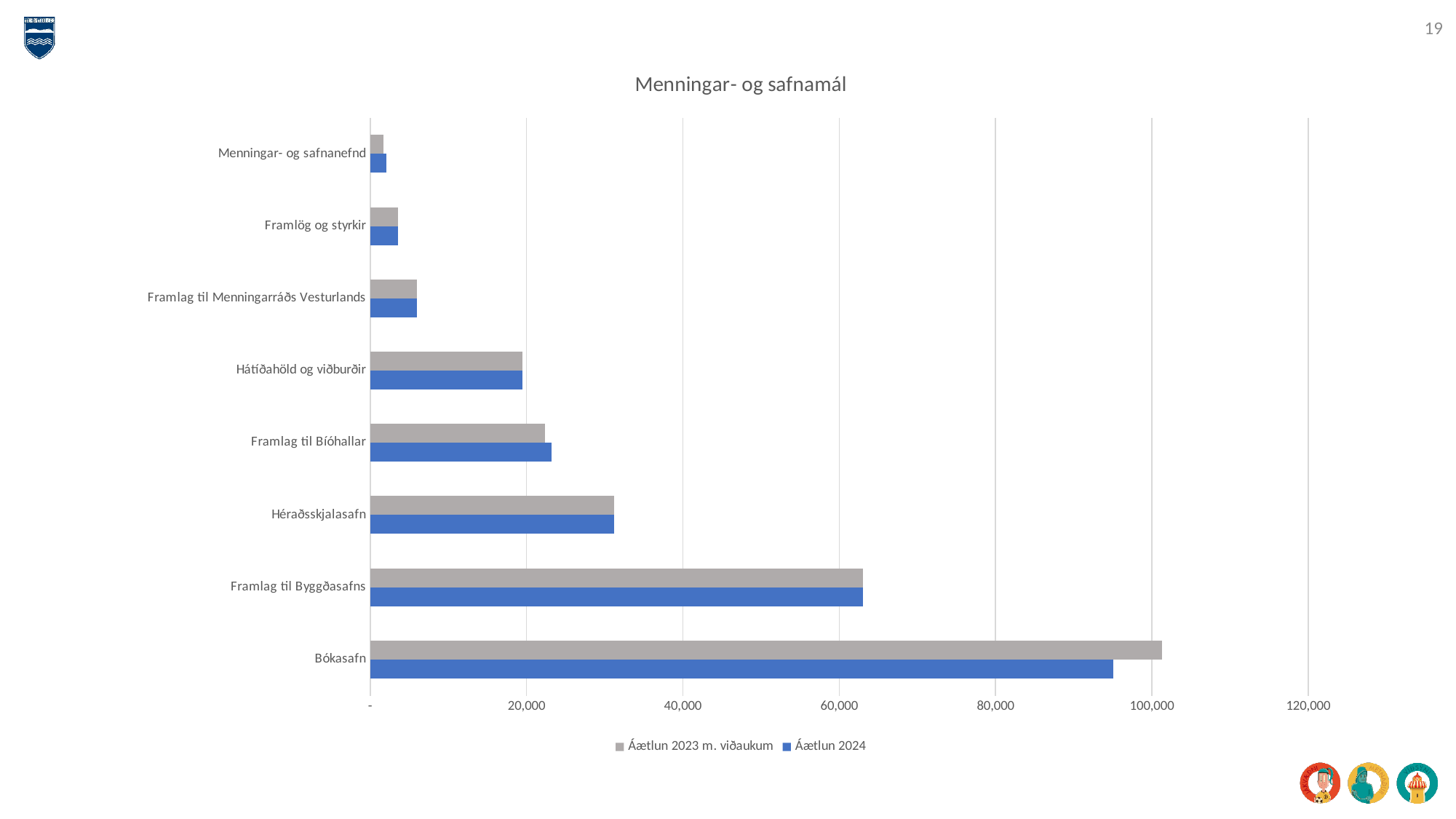
Is the Áætlun 2024 value for Bókasafn greater or less than 80,000? greater How many categories are shown on the chart? 8 Is the Áætlun 2023 m. viðaukum value for Bókasafn greater or less than 100,000? greater What is the title of the chart? Menningar- og safnamál Which category has the lowest value for Áætlun 2023 m. viðaukum? Menningar- og safnanefnd What kind of chart is shown on the slide? bar chart For Bókasafn, which is larger: the Áætlun 2023 m. viðaukum value or the Áætlun 2024 value? Áætlun 2023 m. viðaukum Which category has the highest value for Áætlun 2024? Bókasafn Which series is shown in blue in the legend? Áætlun 2024 How many series does the legend list? 2 Is the Áætlun 2024 value for Framlag til Byggðasafns greater or less than 60,000? greater